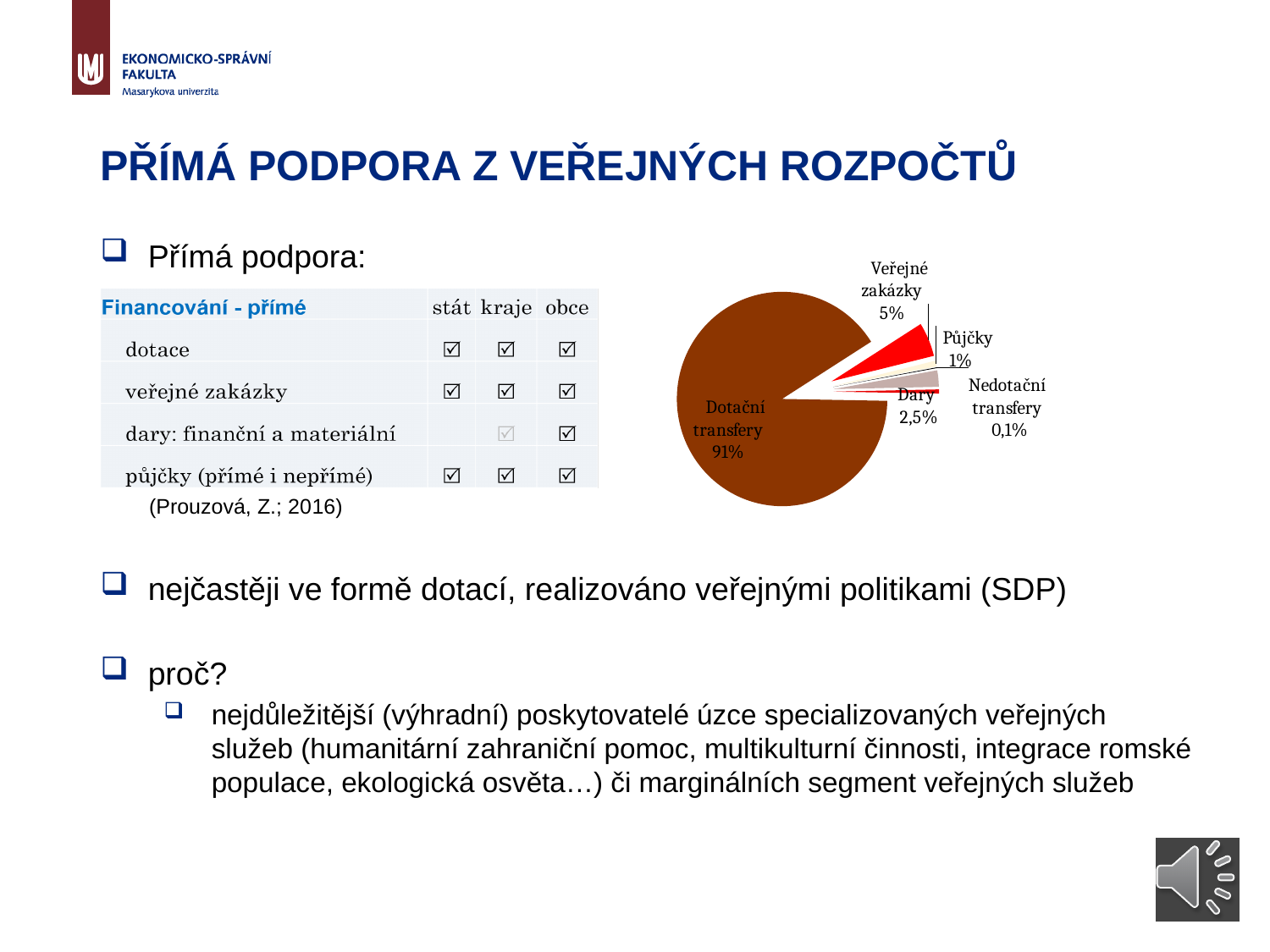
What is the difference between the shares of Veřejné zakázky and Půjčky? 4% How many slices does the pie chart have? 6 Which is larger in the pie chart, Veřejné zakázky or Dary? Veřejné zakázky What colour is the Dotační transfery slice in the pie chart? brown What kind of chart is shown on the slide? pie chart What share of the pie does Půjčky hold? 1% What share of the pie does Veřejné zakázky hold? 5% Which slice of the pie chart is the largest? Dotační transfery What share of the pie does Dotační transfery hold? 91% Which slice of the pie chart is the smallest? Nedotační transfery